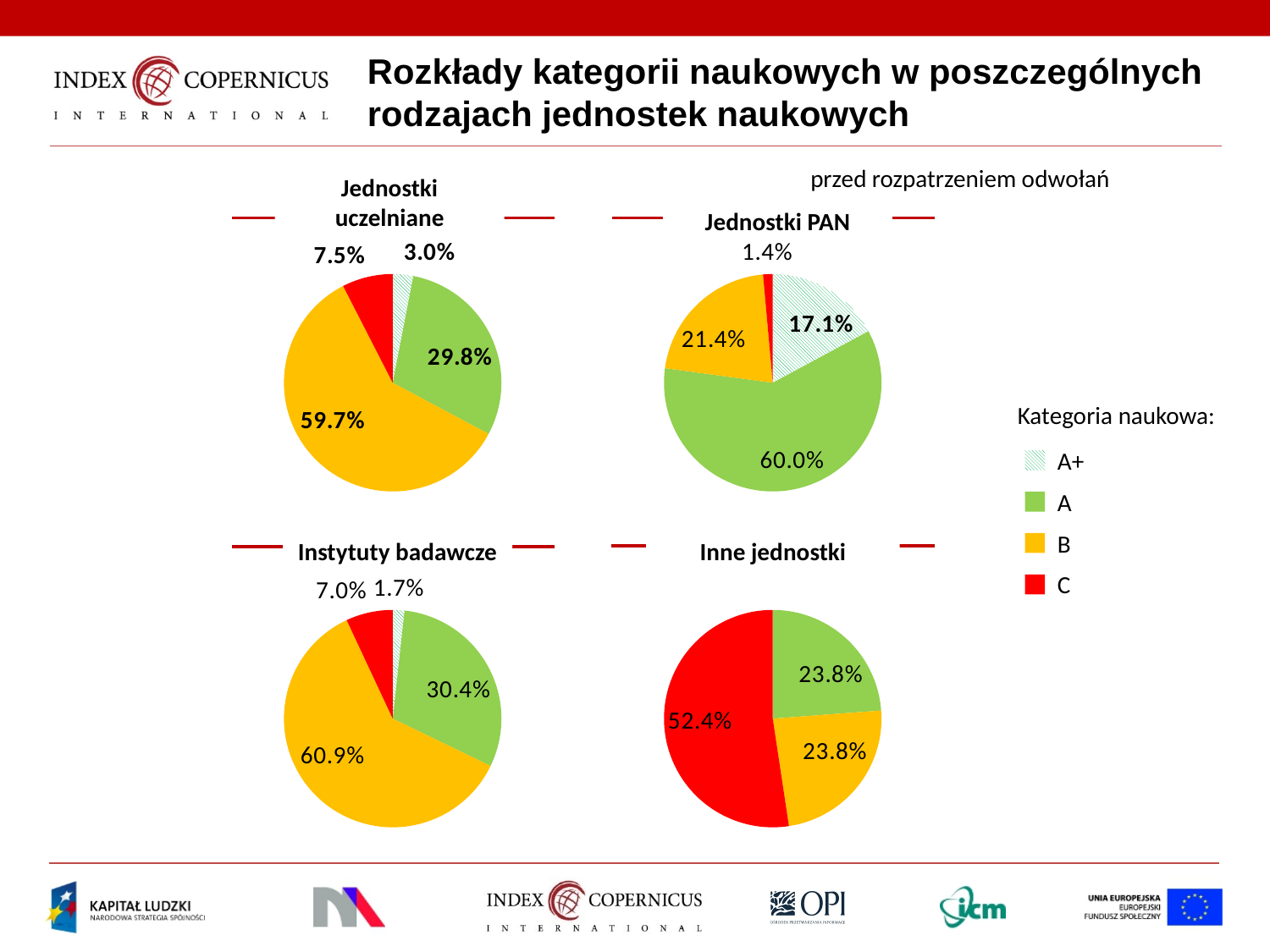
In the "Jednostki uczelniane" pie chart, what share does category B have? 59.7% In the "Jednostki PAN" pie chart, what share does category A have? 60.0% Which colour represents category C in the legend? Red In the "Jednostki uczelniane" pie chart, which category has the largest share? B In the "Jednostki PAN" pie chart, which category has the smallest share? C In the "Inne jednostki" pie chart, what share does category C have? 52.4% How many slices does the "Inne jednostki" pie chart have? 3 How many categories does the legend "Kategoria naukowa" list? 4 What type of chart is used for "Jednostki uczelniane"? Pie chart In the "Jednostki PAN" pie chart, which is larger: the share of category A+ or the share of category B? B In the "Instytuty badawcze" pie chart, what is the difference between the shares of category B and category A? 30.5% In the "Instytuty badawcze" pie chart, what share does category A+ have? 1.7%